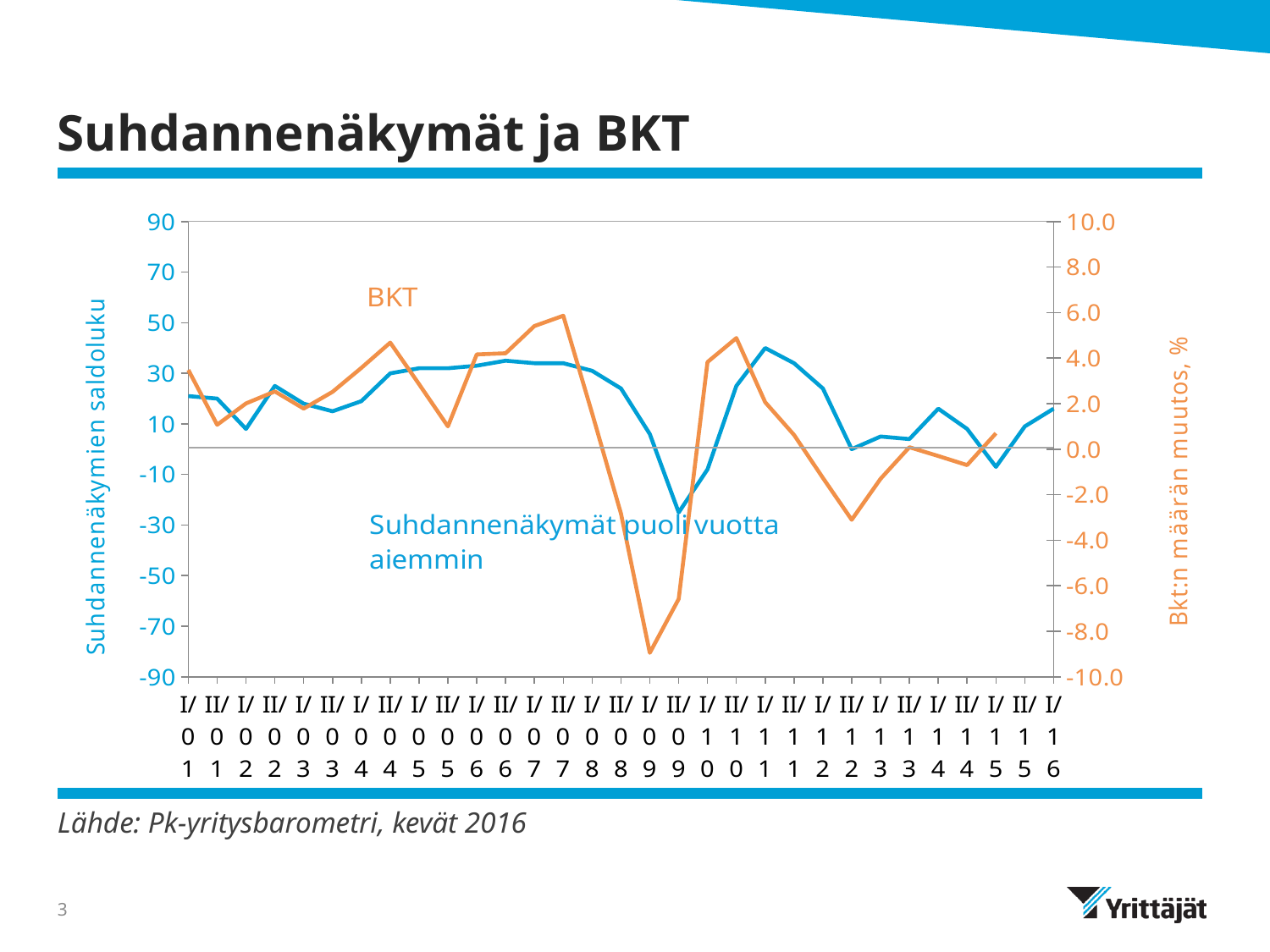
At which time point does the BKT series reach its lowest value? I/09 Which is larger for the Suhdannenäkymät puoli vuotta aiemmin series: the value at I/11 or the value at I/16? I/11 What is the title of the slide? Suhdannenäkymät ja BKT What kind of chart is shown on the slide? line chart Is the Suhdannenäkymät puoli vuotta aiemmin value at I/11 greater or less than 30? greater Does the Suhdannenäkymät puoli vuotta aiemmin series rise or fall between I/09 and II/09? fall At which time point does the BKT series reach its highest value? II/07 How many series are plotted in the chart? 2 How many time points are shown on the x axis? 31 What is the label of the right-hand vertical axis? Bkt:n määrän muutos, % Is the BKT value at II/09 greater or less than -6.0? less At which time point does the Suhdannenäkymät puoli vuotta aiemmin series reach its lowest value? II/09